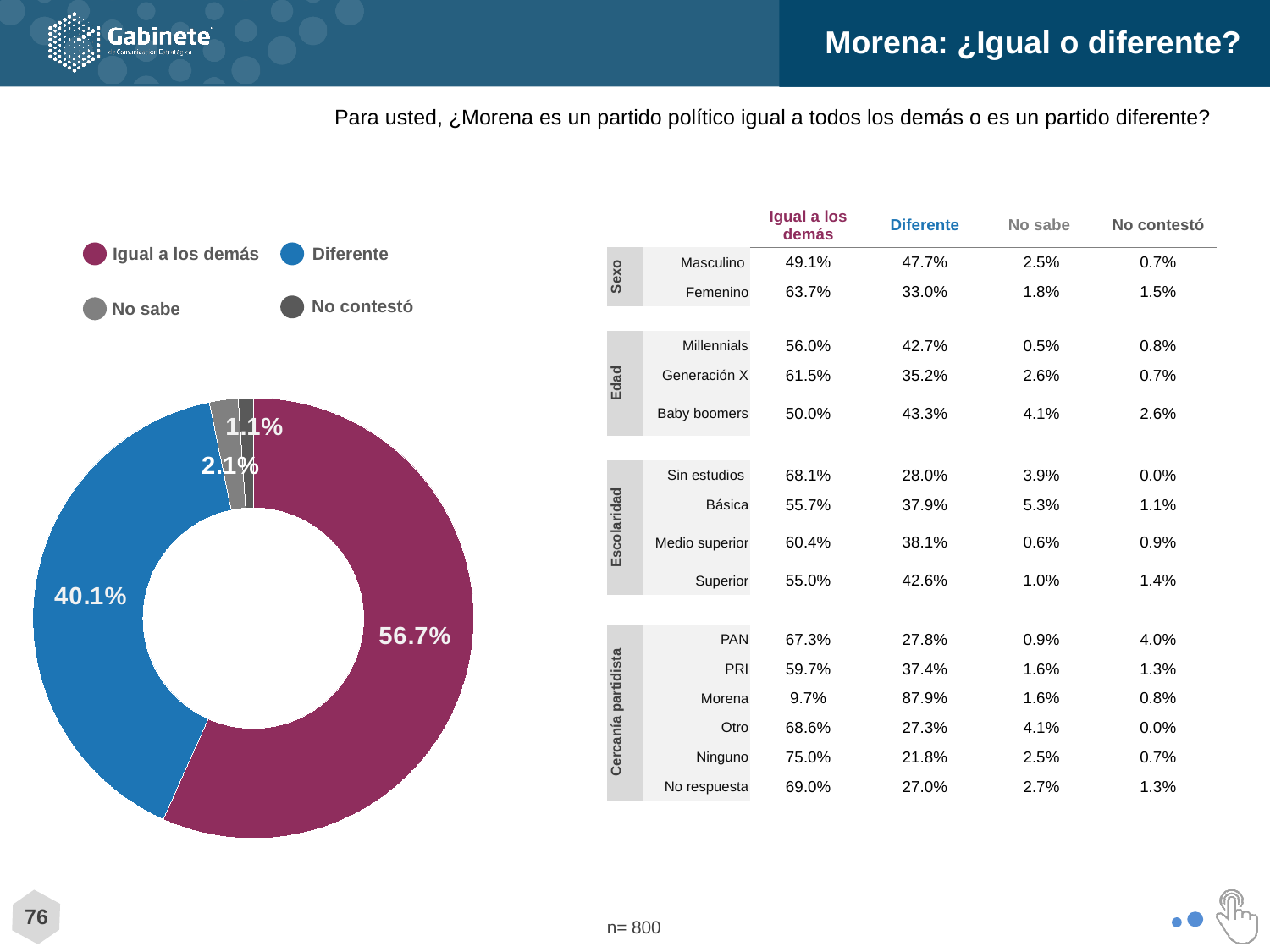
What colour represents 'Diferente' in the donut chart? Blue Which response has the smallest slice in the donut chart? No contestó What percentage of respondents answered 'No contestó'? 1.1% What share of respondents said Morena is 'Igual a los demás'? 56.7% What share of respondents said Morena is 'Diferente'? 40.1% Which response has the largest slice in the donut chart? Igual a los demás How many slices does the donut chart have? 4 Which is larger in the donut chart, 'No sabe' or 'No contestó'? No sabe What kind of chart is shown on the left of the slide? Donut (pie) chart What is the difference in percentage points between 'Igual a los demás' and 'Diferente'? 16.6 percentage points How many entries does the legend of the donut chart list? 4 What percentage of respondents answered 'No sabe'? 2.1%